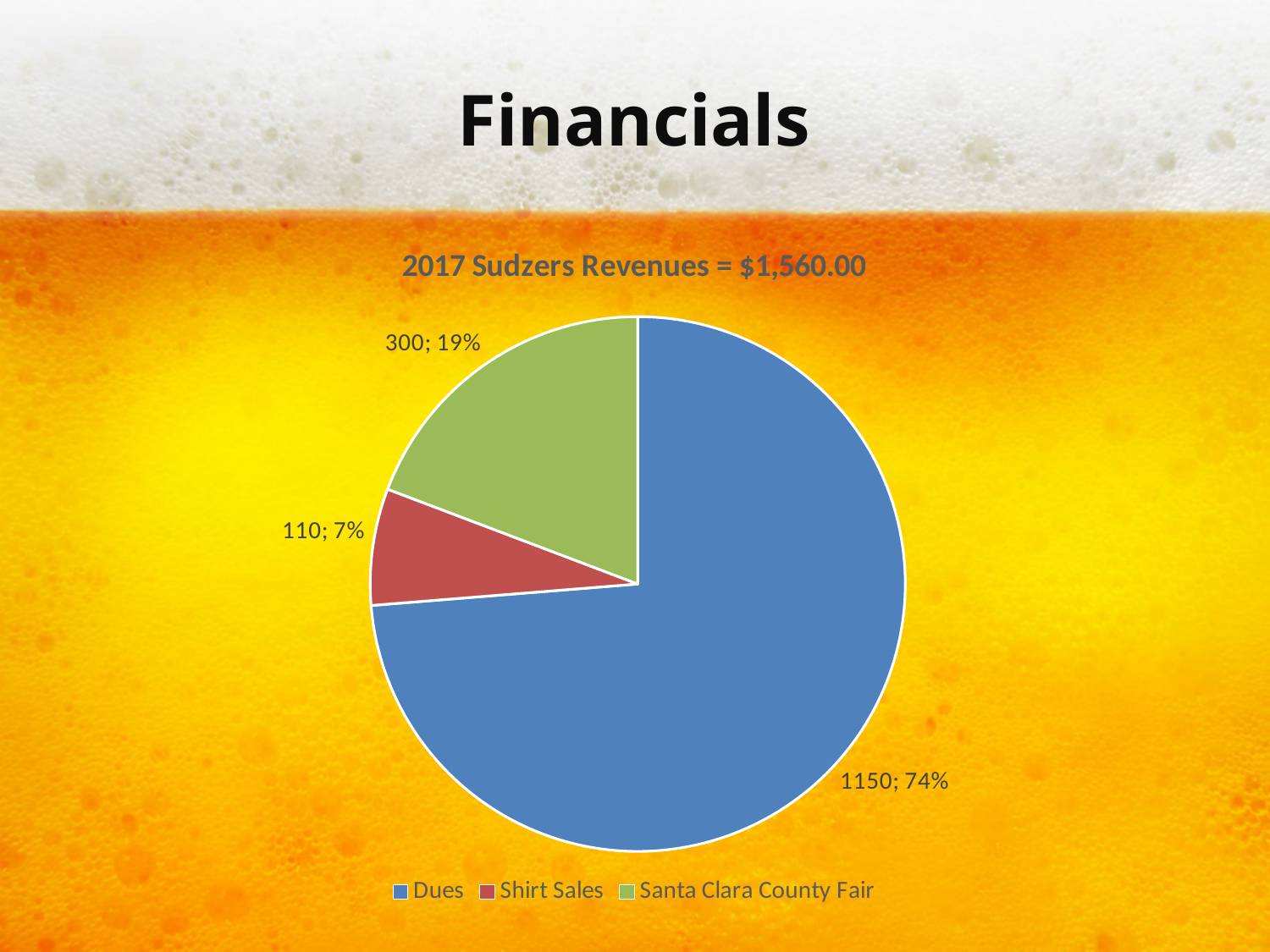
What is the difference between the values for Dues and Santa Clara County Fair? 850 Which category has the largest slice? Dues Which is larger, Shirt Sales or Santa Clara County Fair? Santa Clara County Fair What is the value for Shirt Sales? 110 How many categories does the legend list? 3 What share of the pie does Santa Clara County Fair represent? 19% What kind of chart is shown on the slide? pie chart What is the title of the chart? 2017 Sudzers Revenues = $1,560.00 What is the value for Santa Clara County Fair? 300 What share of the pie does Dues represent? 74% What is the value for Dues? 1150 Which category has the smallest slice? Shirt Sales